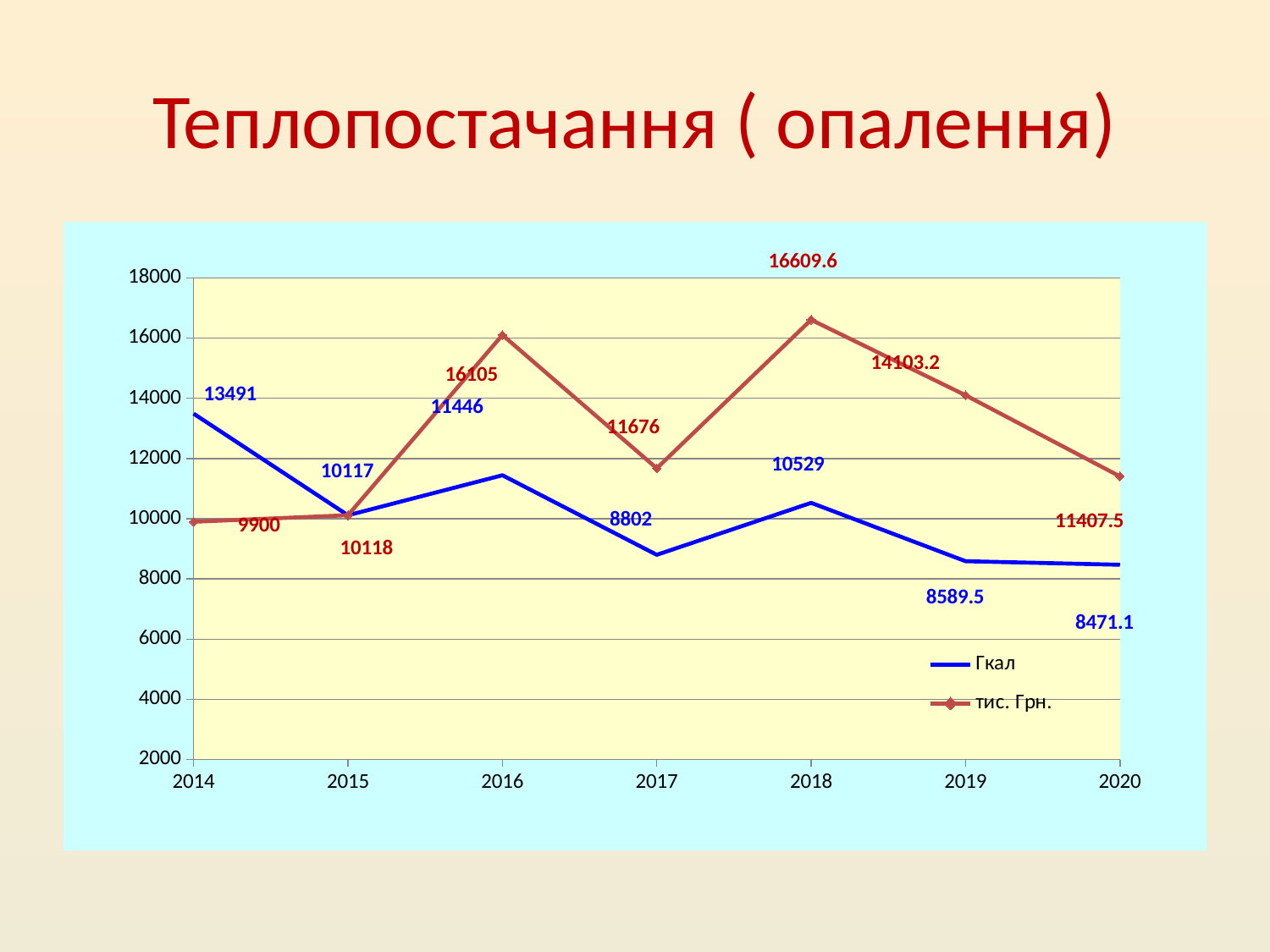
In which year is the Гкал series lowest? 2020 What is the value of the Гкал series in 2020? 8471.1 What is the value of the Гкал series in 2014? 13491 How many years are shown on the x axis? 7 What kind of chart is shown on the slide? line chart In which year is the тис. Грн. series highest? 2018 How many series does the legend list? 2 What is the value of the тис. Грн. series in 2016? 16105 What is the difference between the тис. Грн. value in 2018 and in 2017? 4933.6 What is the value of the тис. Грн. series in 2018? 16609.6 Is the Гкал value in 2019 greater or less than 10000? less Which is larger in 2014: the Гкал value or the тис. Грн. value? Гкал